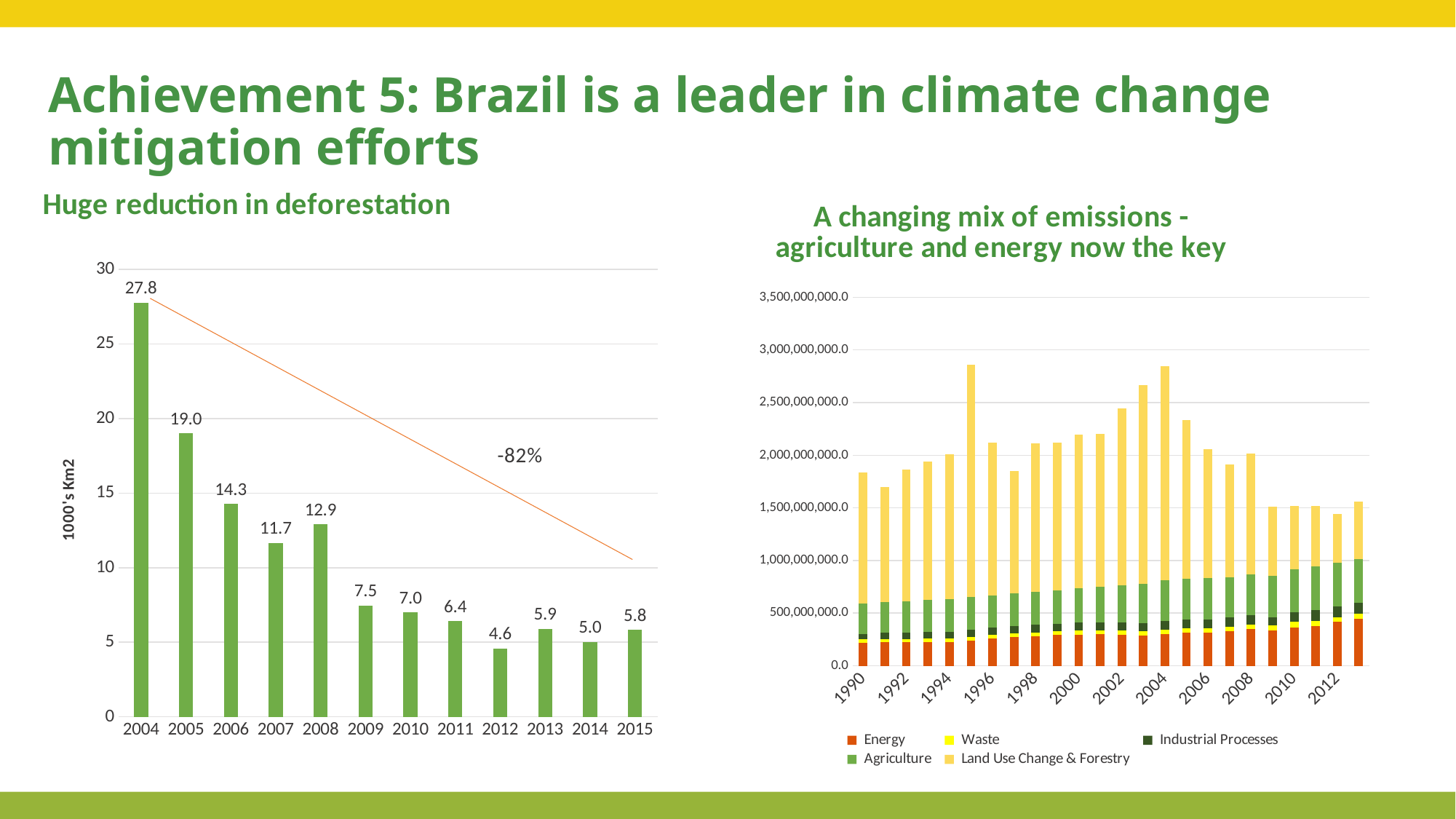
In the 'Huge reduction in deforestation' chart, what is the difference between the values for 2004 and 2015? 22.0 In the 'Huge reduction in deforestation' chart, what percentage change is annotated next to the trend line? -82% How many years are shown in the 'Huge reduction in deforestation' chart? 12 In the 'Huge reduction in deforestation' chart, which year has the larger value, 2007 or 2008? 2008 In the 'Huge reduction in deforestation' chart, what is the value for 2004? 27.8 In the 'A changing mix of emissions' chart, is the total for 1995 greater or less than 2,500,000,000.0? greater How many series does the legend of the 'A changing mix of emissions' chart list? 5 In the 'A changing mix of emissions' chart, does the Energy series rise or fall from 1990 to 2012? Rise In the 'Huge reduction in deforestation' chart, which year has the highest value? 2004 What kind of chart is the 'A changing mix of emissions' chart on the right? Stacked bar chart In the 'Huge reduction in deforestation' chart, which year has the lowest value? 2012 In the 'Huge reduction in deforestation' chart, what is the value for 2012? 4.6